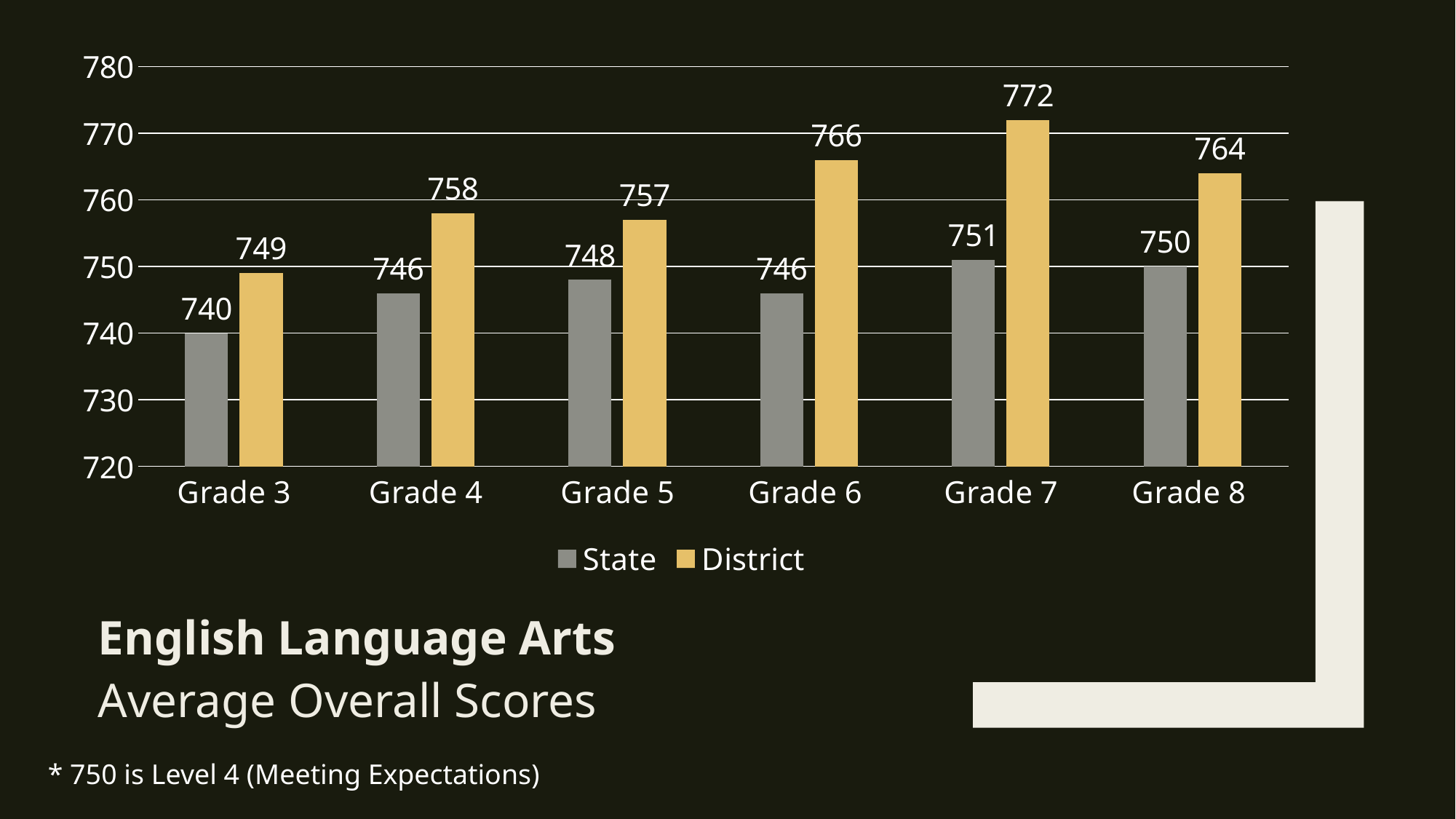
What is the District score for Grade 5? 757 How many grades are shown on the x axis? 6 Is the District score for Grade 4 greater or less than 750? greater What is the difference between the District and State scores for Grade 6? 20 What kind of chart is shown on the slide? Bar chart Which is larger, the State score for Grade 7 or the State score for Grade 8? Grade 7 Which grade has the highest District score? Grade 7 How many series does the legend list? 2 What is the State average overall score for Grade 3? 740 What is the District average overall score for Grade 7? 772 Which grade has the lowest State score? Grade 3 What is the difference between the District scores for Grade 7 and Grade 8? 8